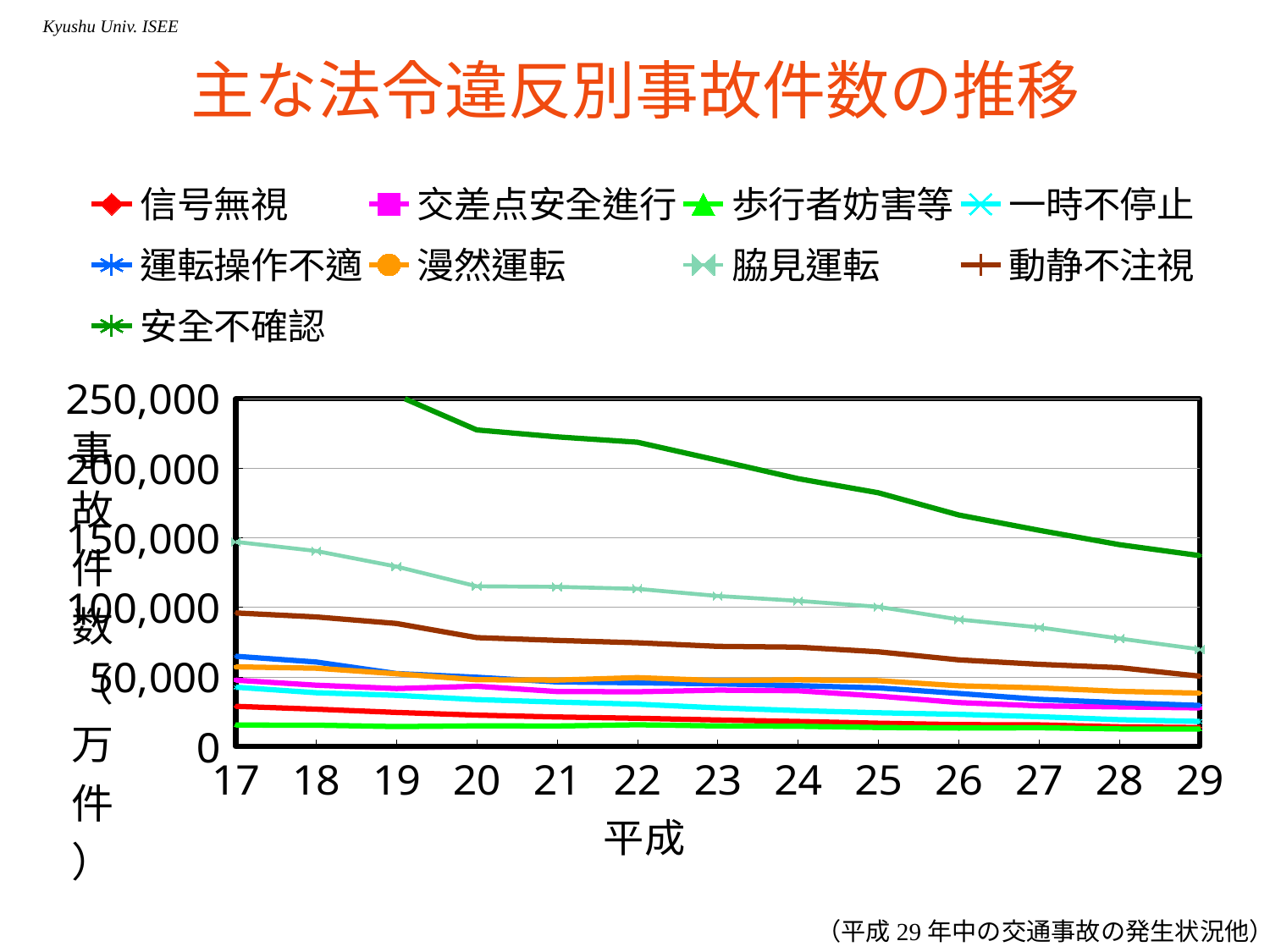
In 平成29, which is larger: 脇見運転 or 動静不注視? 脇見運転 Does the value for 脇見運転 rise or fall from 平成17 to 平成29? fall What is the title of the chart? 主な法令違反別事故件数の推移 What is the label of the x axis? 平成 How many series does the legend list? 9 Does the value for 安全不確認 rise or fall from 平成20 to 平成29? fall Is the value for 安全不確認 in 平成29 greater or less than 100,000? greater What kind of chart is shown on the slide? line chart Is the value for 脇見運転 in 平成29 greater or less than 100,000? less Which series has the highest value in 平成29? 安全不確認 Which series has the lowest value in 平成17? 歩行者妨害等 How many years (points) are shown along the x axis? 13